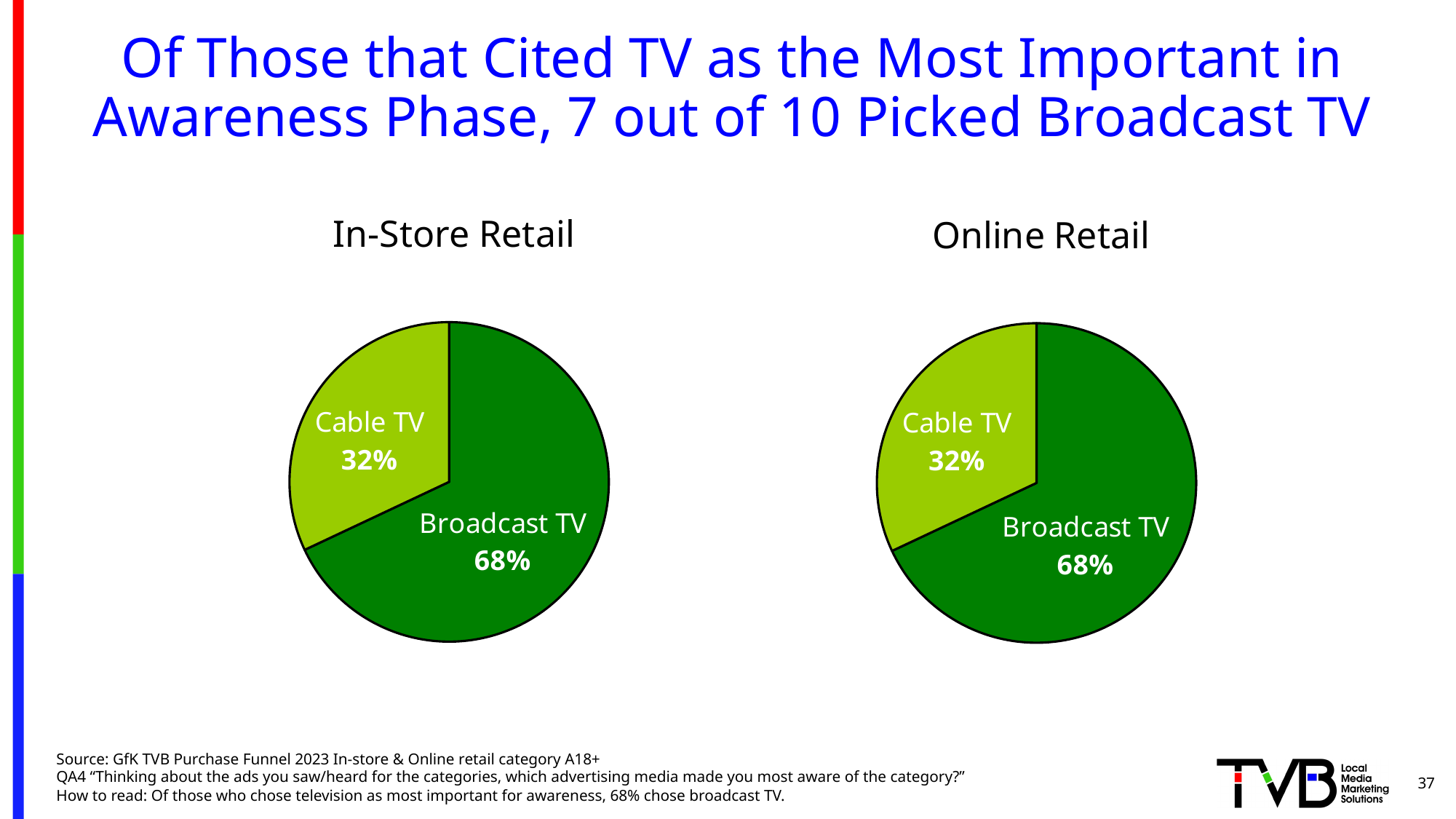
In the In-Store Retail chart, which slice is shown in the lighter green colour? Cable TV How many pie charts are shown on the slide? 2 In the In-Store Retail chart, what is the difference between the Broadcast TV and Cable TV shares? 36 percentage points In the Online Retail chart, what share did Broadcast TV receive? 68% In the In-Store Retail chart, what share did Broadcast TV receive? 68% How many slices does the Online Retail pie chart have? 2 In the Online Retail chart, what share did Cable TV receive? 32% In the Online Retail chart, which is larger, Broadcast TV or Cable TV? Broadcast TV What kind of chart is the In-Store Retail chart? Pie chart In the Online Retail chart, which slice is the smallest? Cable TV In the In-Store Retail chart, what share did Cable TV receive? 32% In the In-Store Retail chart, which slice is the largest? Broadcast TV